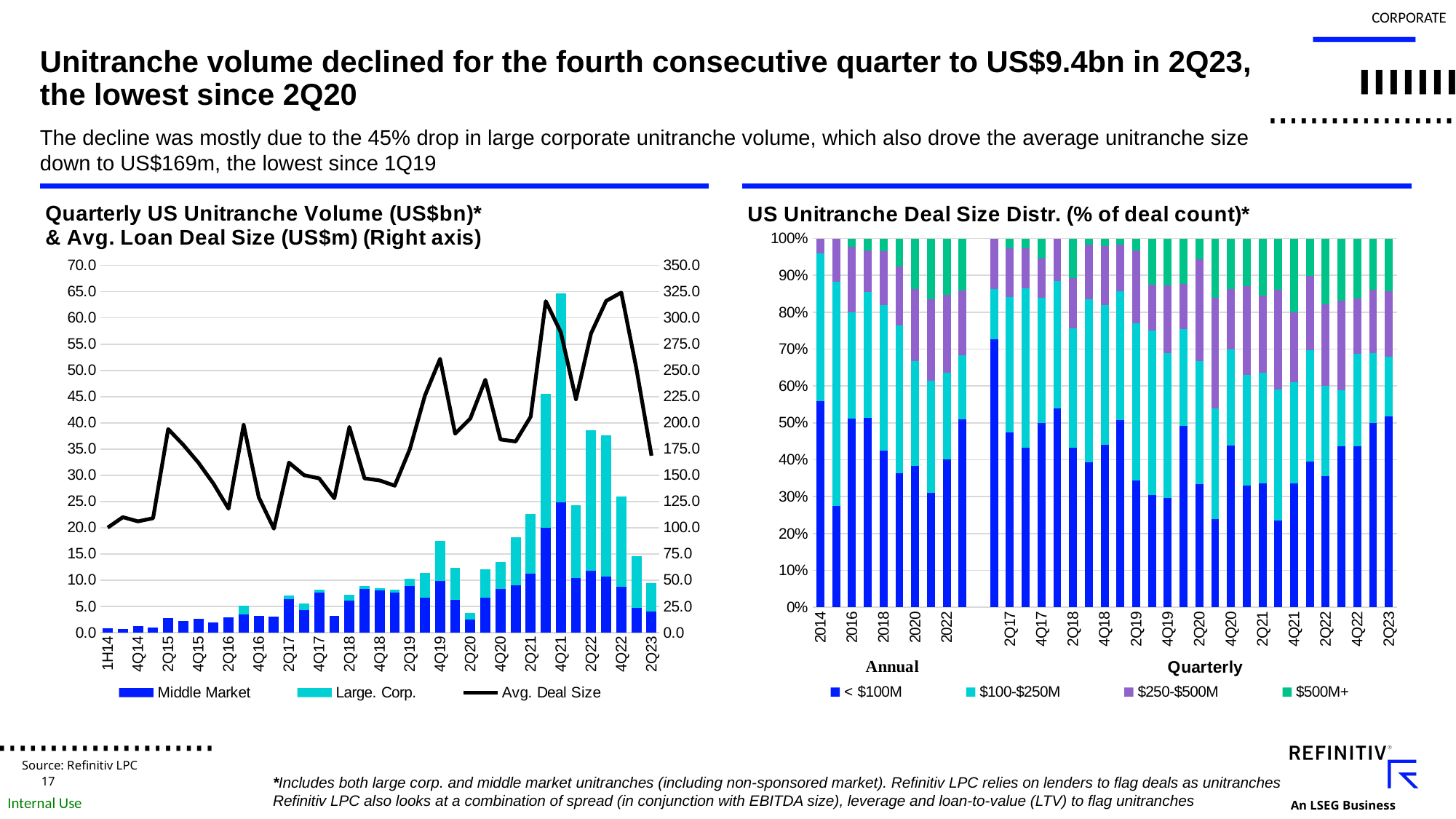
On the left chart, is the total volume bar for 2Q23 greater or less than 15.0? less On the left chart, how many series does the legend list? 3 On the right chart, what are the two groups of bars labeled? Annual and Quarterly On the left chart, what kind of chart is used for the Middle Market and Large Corp. series? bar chart On the left chart, is the total volume bar for 4Q21 greater or less than 60.0? greater On the left chart, which series is drawn as a line rather than bars? Avg. Deal Size On the right chart, how many series does the legend list? 4 On the right chart, among the Annual bars, which year has the largest < $100M share? 2014 On the left chart, is the Avg. Deal Size value for 4Q22 greater or less than 300.0? greater On the left chart, which quarter has the highest total unitranche volume? 4Q21